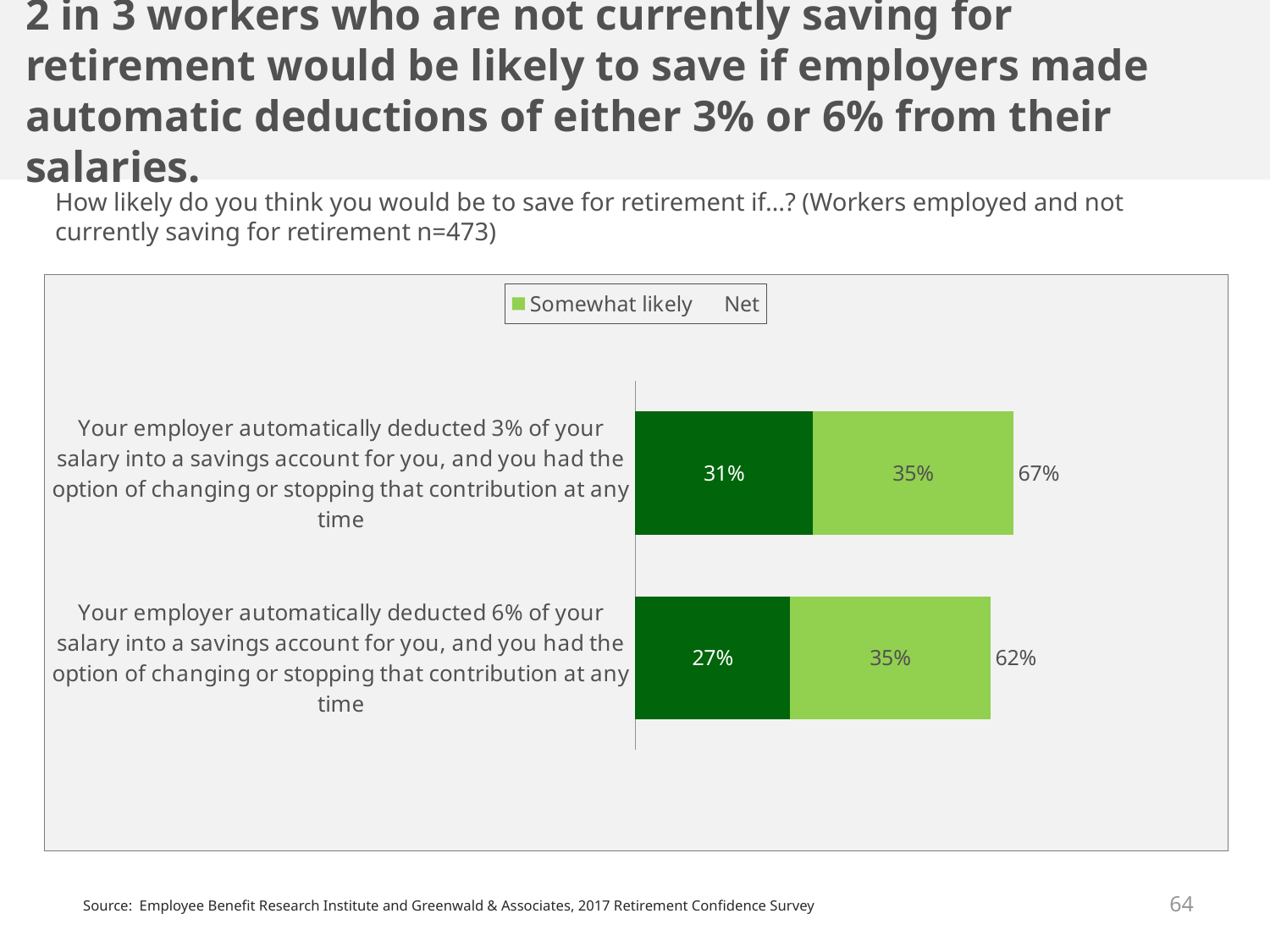
What percentage of workers said they would be somewhat likely to save if their employer automatically deducted 3% of their salary? 35% What two entries are listed in the chart's legend? Somewhat likely and Net How many scenarios (categories) are plotted in the chart? 2 What percentage of workers said they would be somewhat likely to save under the 6% automatic deduction option? 35% What value is printed in the dark green segment of the bar for the 6% automatic deduction option? 27% Which option has the higher Net value: the 3% automatic deduction or the 6% automatic deduction? 3% automatic deduction What is the Net value shown for the option where the employer automatically deducts 6% of salary? 62% What is the difference between the Net values for the 3% deduction option and the 6% deduction option? 5 percentage points What value is printed in the dark green segment of the bar for the 3% automatic deduction option? 31% What is the Net value shown for the option where the employer automatically deducts 3% of salary? 67% What type of chart is shown on the slide? Stacked bar chart What is the difference between the dark green segment values for the 3% deduction option (31%) and the 6% deduction option (27%)? 4 percentage points